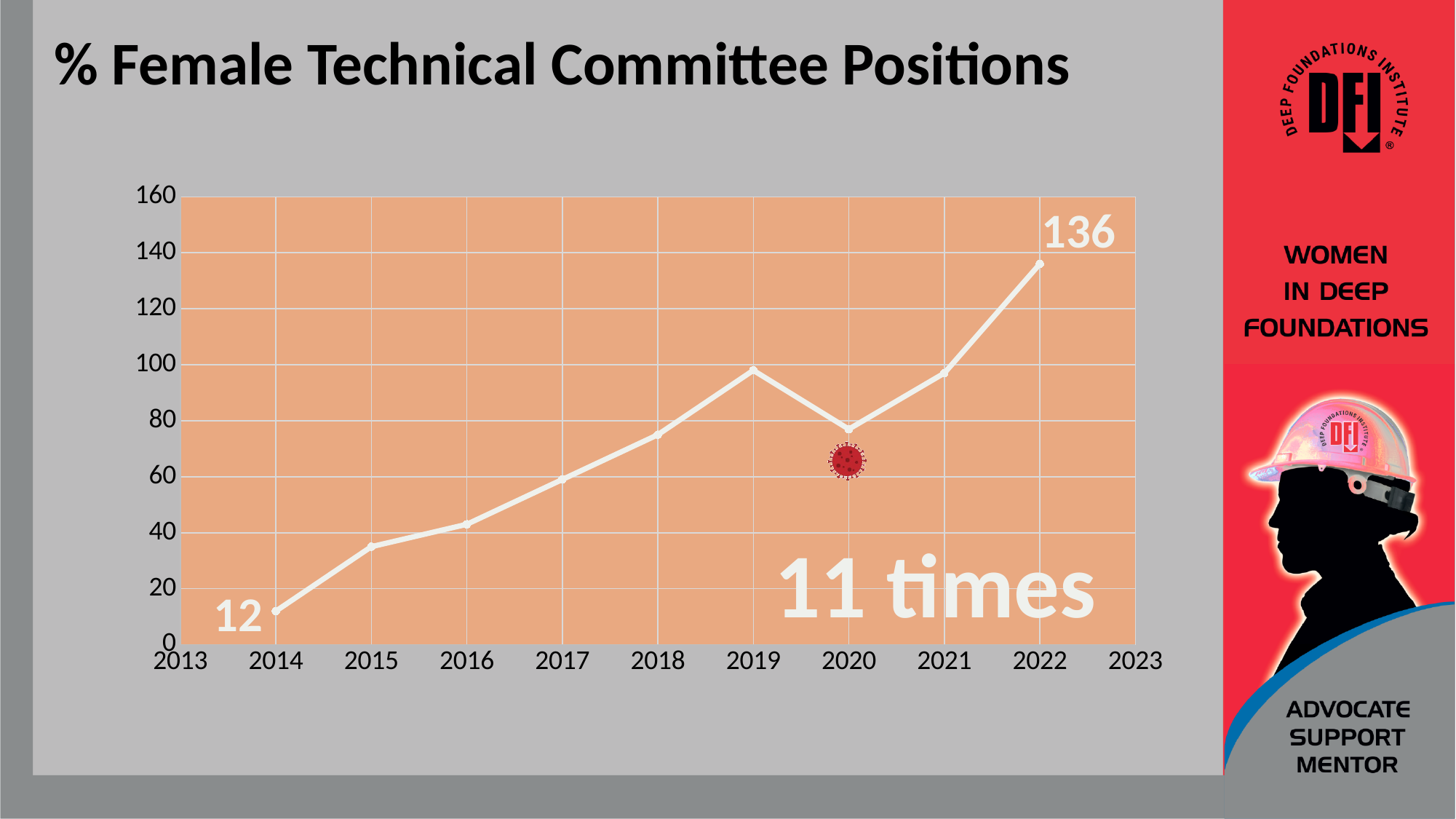
Is the value for 2019 greater or less than 80? greater What is the value for 2014? 12 Is the value for 2015 greater or less than 40? less Do the values generally rise or fall from 2014 to 2022? Rise Which year has the larger value, 2019 or 2020? 2019 Is the value for 2020 greater or less than 100? less What kind of chart is shown on the slide? Line chart What is the title of the chart? % Female Technical Committee Positions Which year has the highest value? 2022 What is the value for 2022? 136 Which year has the lowest value? 2014 What is the difference between the 2022 value and the 2014 value? 124